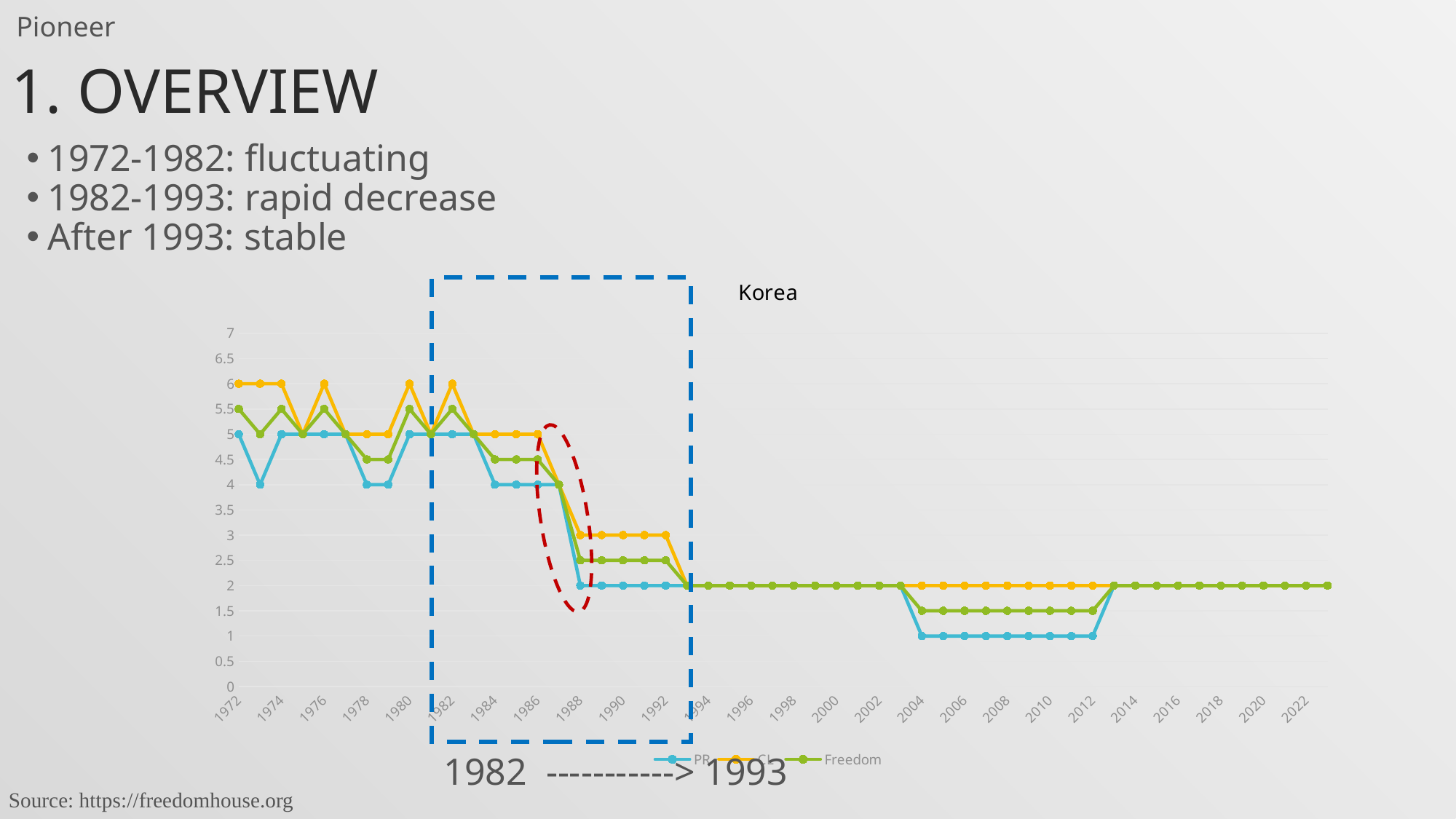
What is the value of the Freedom series in 1972? 5.5 Which series has the higher value in 1990, CL or PR? CL What is the difference between the CL value and the PR value in 1972? 1 What kind of chart is shown on the slide? line chart What is the value of the PR series in 2006? 1 What is the value of the CL series in 1990? 3 How many series does the legend of the chart list? 3 What is the value of the PR series in 1972? 5 What is the value of the CL series in 1972? 6 Does the PR series rise or fall between 1982 and 1993? fall What is the value of the Freedom series in 2008? 1.5 What is the title of the chart? Korea